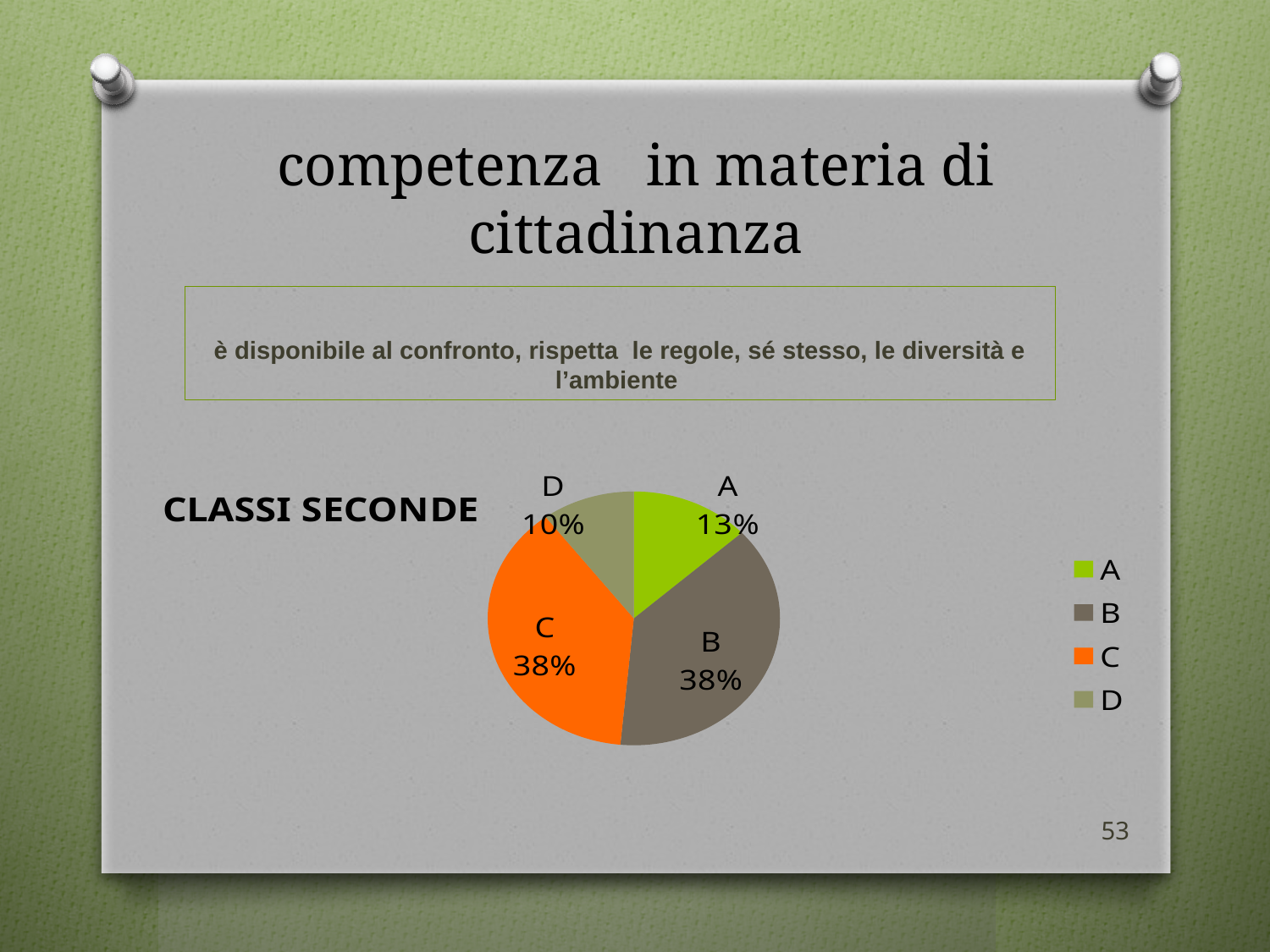
What percentage does slice D represent in the pie chart? 10% Which slice of the pie chart is the smallest? D What is the difference in percentage points between slice B and slice A? 25 Which is larger, slice A or slice D? A What label appears to the left of the pie chart? CLASSI SECONDE How many entries does the legend list? 4 What kind of chart is shown on the slide? pie chart What percentage does slice C represent in the pie chart? 38% What is the difference in percentage points between slice A and slice D? 3 What percentage does slice B represent in the pie chart? 38% How many slices does the pie chart have? 4 What percentage does slice A represent in the pie chart? 13%